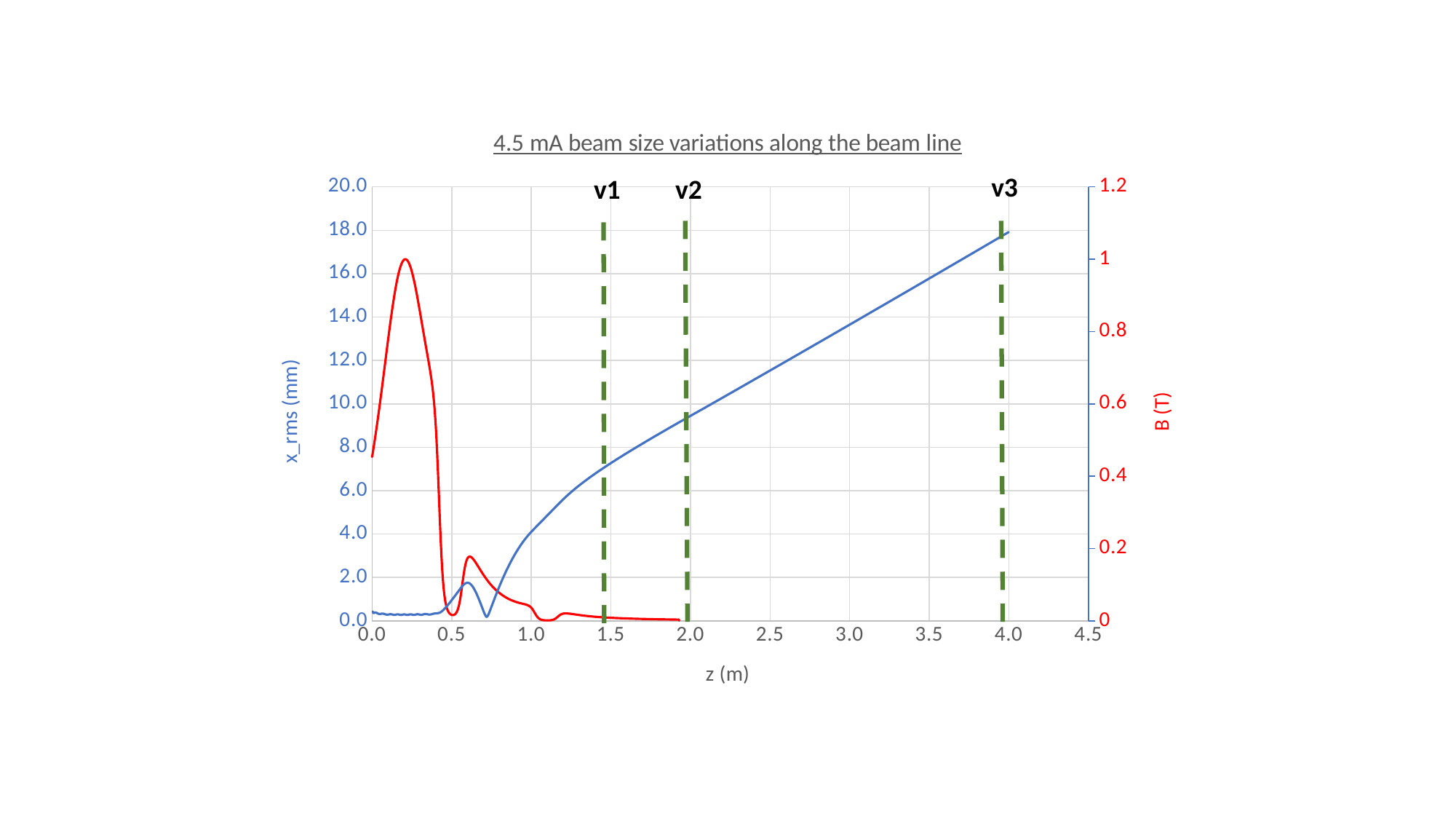
What is the title of the chart? 4.5 mA beam size variations along the beam line How many vertical dashed marker lines (v1, v2, v3) are drawn on the chart? 3 What is the label of the left vertical axis? x_rms (mm) Does the B (T) curve rise or fall between z = 0.2 m and z = 0.5 m? fall Does the x_rms curve rise or fall between z = 1.5 m and z = 4.0 m? rise What kind of chart is shown on the slide? line chart Is the peak value of B (T) greater or less than 0.8? greater Is the x_rms value at z = 4.0 m greater or less than 16.0? greater Is the x_rms value at z = 2.0 m greater or less than 8.0? greater Which of the two curves, x_rms or B, reaches its maximum at a larger z value? x_rms